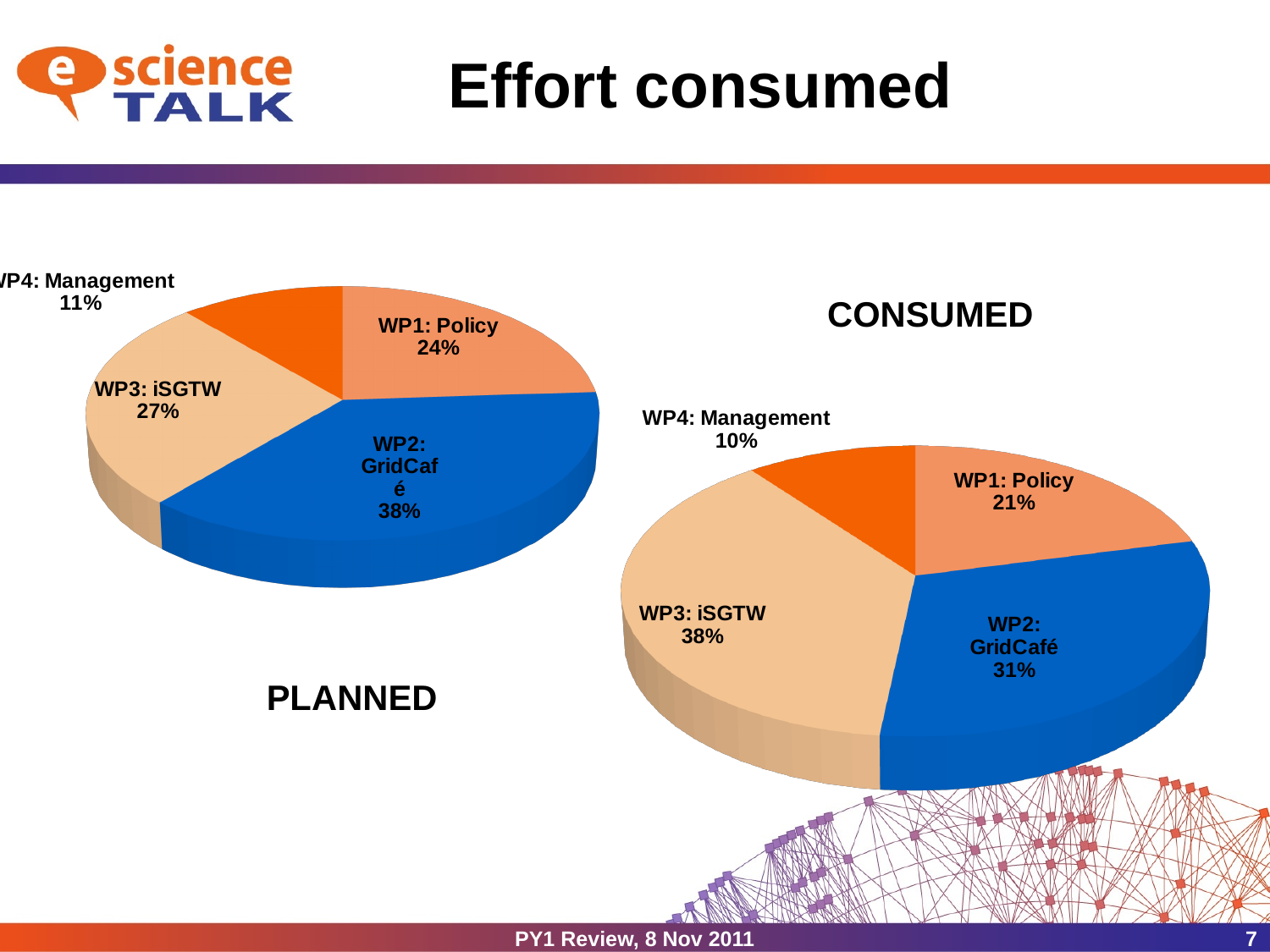
In the CONSUMED pie chart, which work package has the largest share? WP3: iSGTW In the PLANNED pie chart, which work package has the largest share? WP2: GridCafé How many slices does the PLANNED pie chart have? 4 In the PLANNED pie chart, what share does WP3: iSGTW have? 27% In the CONSUMED pie chart, which work package has the smallest share? WP4: Management In the CONSUMED pie chart, what share does WP3: iSGTW have? 38% What is the difference between the WP2: GridCafé share in the PLANNED chart and in the CONSUMED chart? 7% In the PLANNED pie chart, what share does WP2: GridCafé have? 38% What type of chart is used for the CONSUMED data? Pie chart What is the title of the slide containing the two pie charts? Effort consumed In the CONSUMED pie chart, which is larger: the share of WP1: Policy or the share of WP2: GridCafé? WP2: GridCafé In the CONSUMED pie chart, what share does WP1: Policy have? 21%